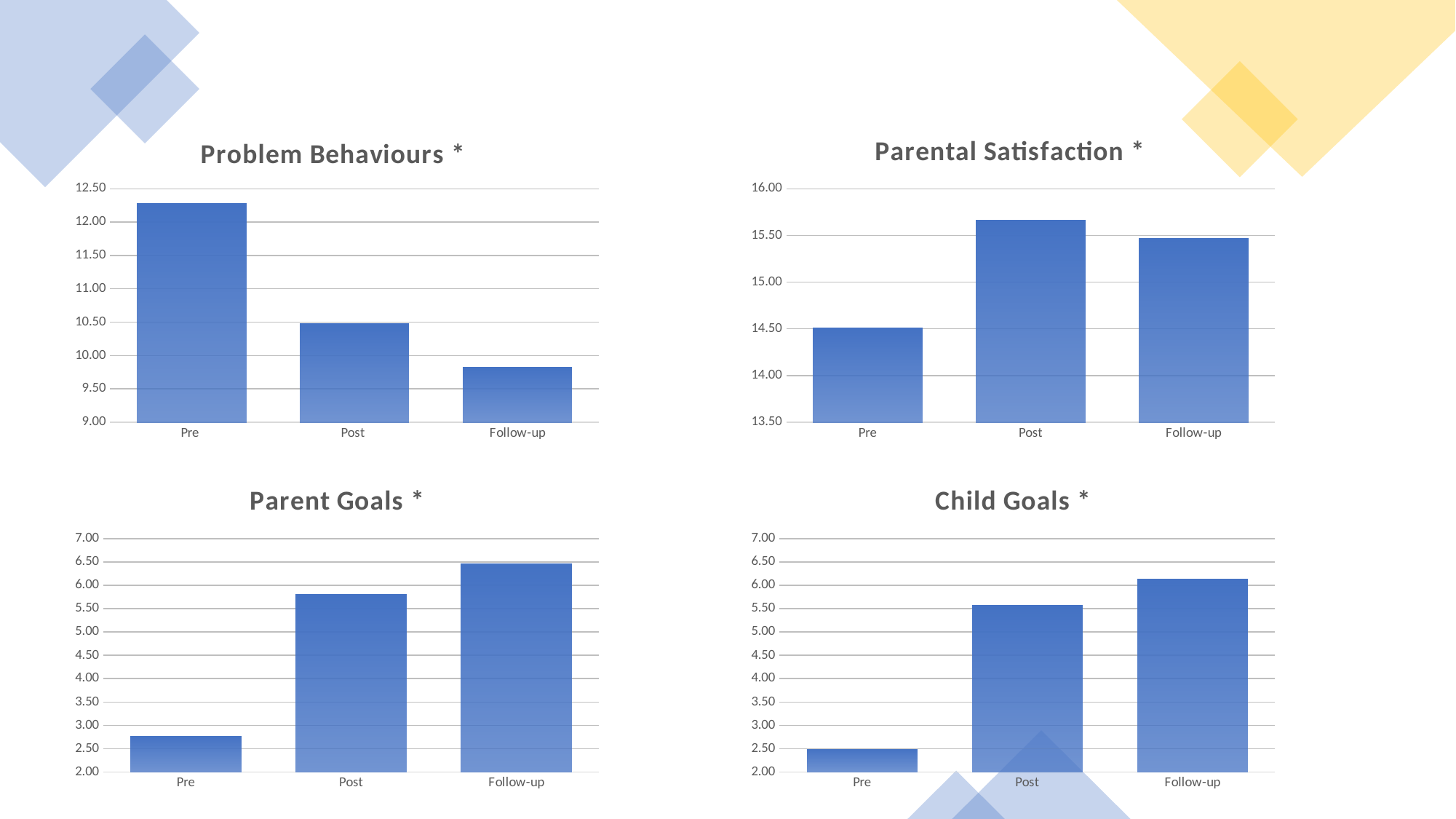
In the Problem Behaviours chart, is the value for Pre greater or less than 12.00? greater In the Child Goals chart, is the value for Follow-up greater or less than 6.00? greater In the Child Goals chart, which category has the lowest value? Pre In the Parent Goals chart, is the value for Pre greater or less than 3.00? less In the Parental Satisfaction chart, which category has the highest value? Post How many categories are shown on the x axis of the Child Goals chart? 3 In the Parent Goals chart, which is larger, the value for Post or the value for Follow-up? Follow-up In the Problem Behaviours chart, do the values rise or fall from Pre to Follow-up? fall In the Parental Satisfaction chart, which category has the lowest value? Pre In the Problem Behaviours chart, which category has the highest value? Pre